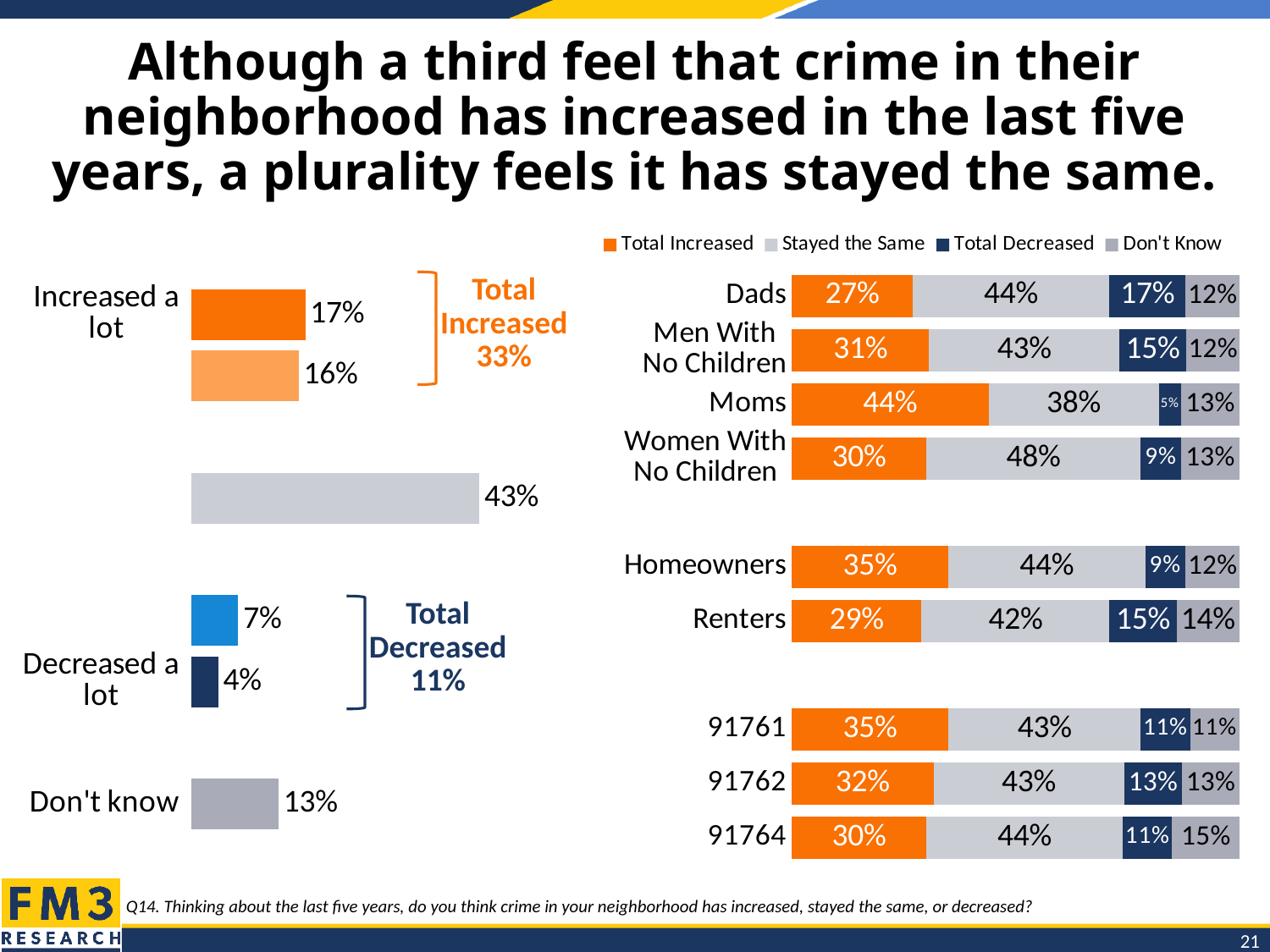
In the left chart, what percentage said 'Don't know'? 13% How many groups are shown in the right chart? 9 In the left chart, what is the 'Total Increased' figure shown? 33% In the right chart, which is larger: the 'Total Increased' value for Homeowners or for Renters? Homeowners What type of chart is the right chart? Stacked bar chart In the right chart, which group has the lowest 'Total Decreased' value? Moms In the right chart, what is the 'Stayed the Same' value for Women With No Children? 48% How many series does the legend of the right chart list? 4 In the right chart, what percentage of Moms are in the 'Total Increased' group? 44% In the left chart, what percentage of respondents said crime 'Increased a lot'? 17% In the left chart, what is the difference between the 'Increased a lot' value and the 'Decreased a lot' value? 13 percentage points In the right chart, which group has the highest 'Total Increased' value? Moms